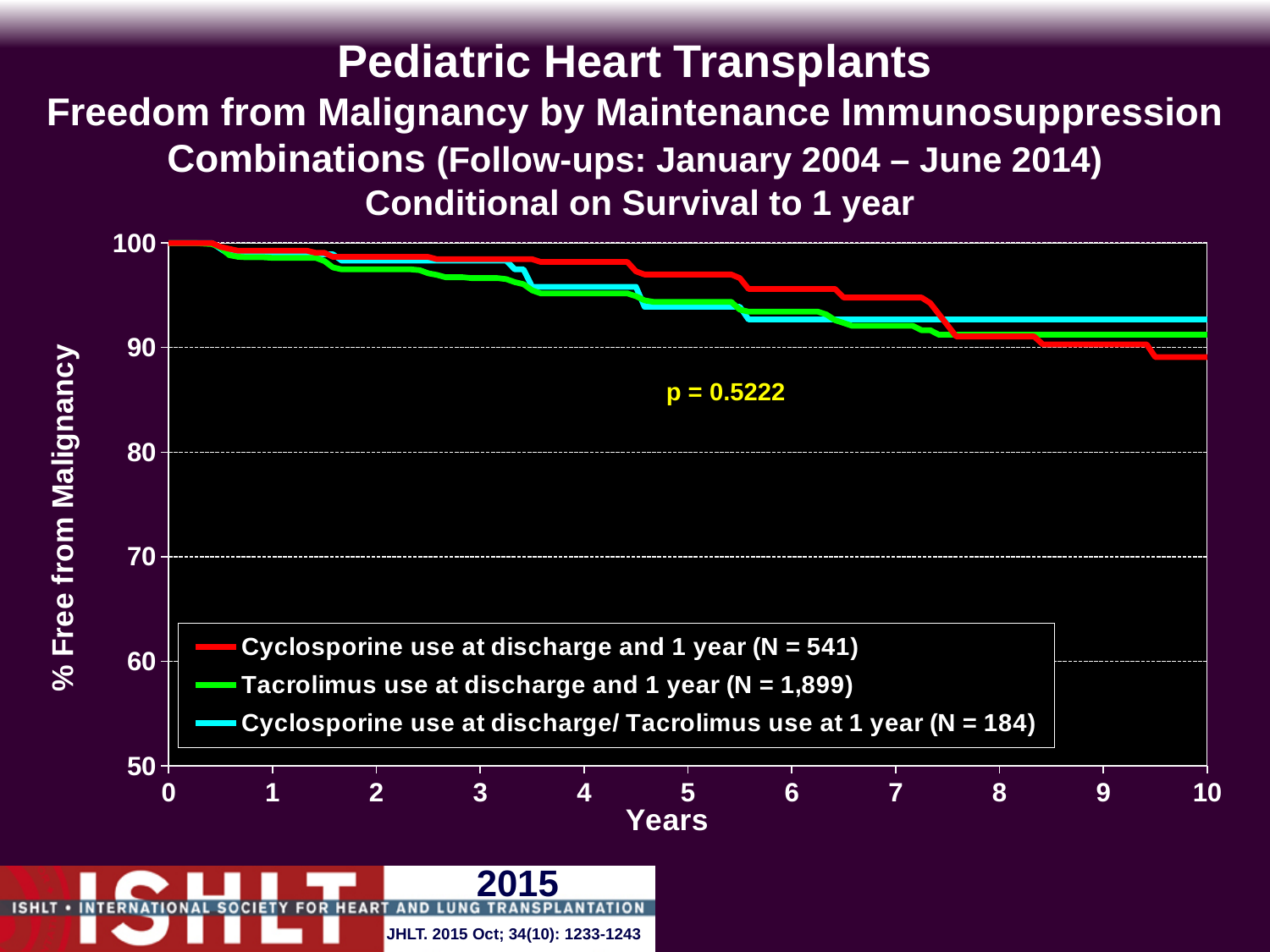
What is the % Free from Malignancy for all three series at year 0? 100 How many series does the legend list? 3 What kind of chart is shown on the slide? line chart Is the value for Tacrolimus use at discharge and 1 year at 10 years greater or less than 90? greater Do the % Free from Malignancy values rise or fall as years increase? fall Is the value for Cyclosporine use at discharge and 1 year at 5 years greater or less than 90? greater What p-value is printed on the chart? p = 0.5222 Which series has the lowest % Free from Malignancy at 10 years? Cyclosporine use at discharge and 1 year At 10 years, which is lower: Cyclosporine use at discharge and 1 year or Tacrolimus use at discharge and 1 year? Cyclosporine use at discharge and 1 year Is the value for Cyclosporine use at discharge/ Tacrolimus use at 1 year at 10 years greater or less than 90? greater What is the N for the Tacrolimus use at discharge and 1 year group? 1,899